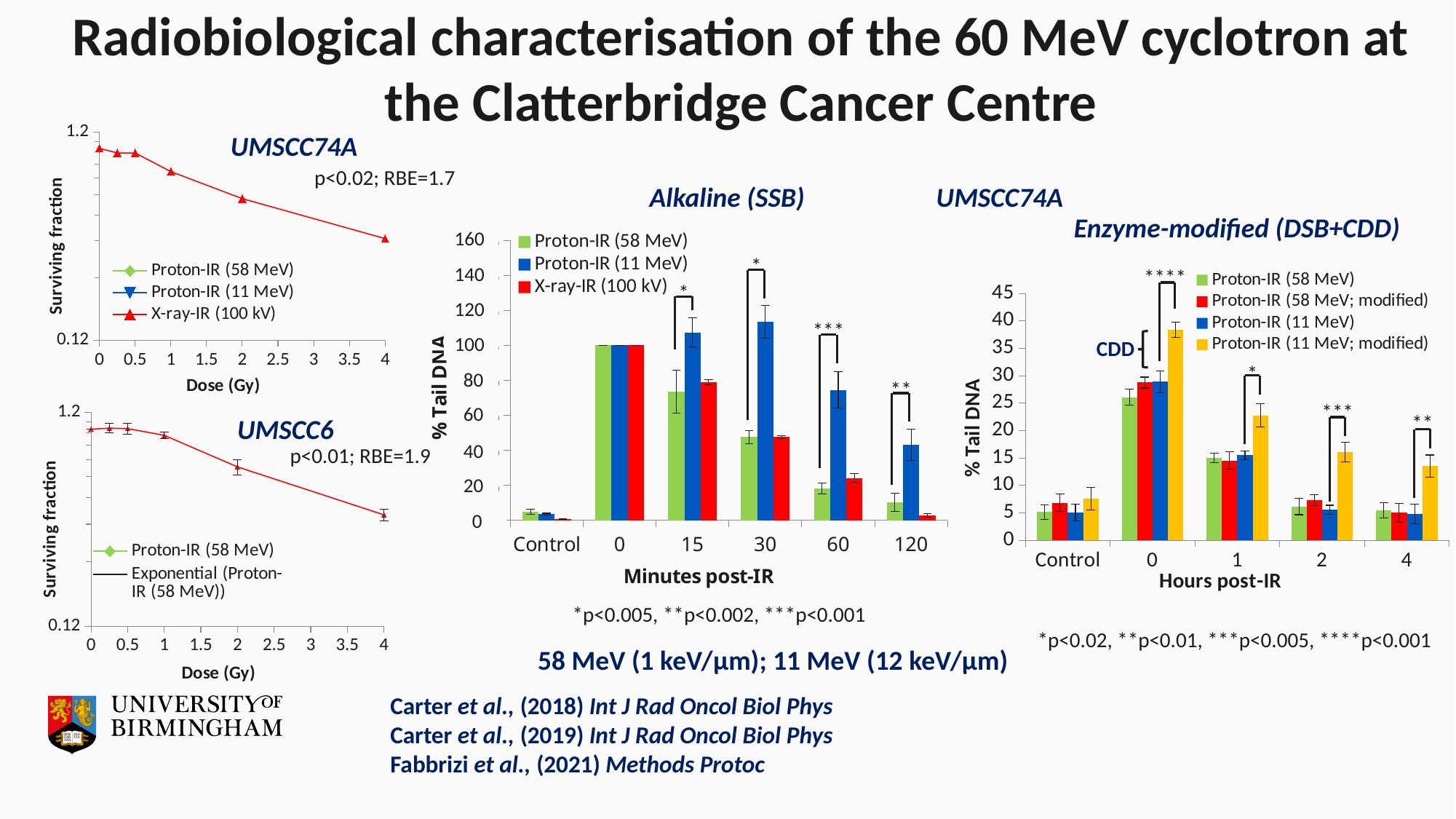
In the Enzyme-modified (DSB+CDD) chart, is the value for Proton-IR (11 MeV; modified) at 0 hours post-IR greater or less than 35? greater What kind of chart is the Enzyme-modified (DSB+CDD) chart? bar chart In the UMSCC6 line chart, does the surviving fraction rise or fall as dose increases from 0 to 4 Gy? fall In the Alkaline (SSB) chart, does the Proton-IR (11 MeV) series rise or fall from 0 to 120 minutes post-IR? fall In the Alkaline (SSB) chart, which series has the highest value at 15 minutes post-IR? Proton-IR (11 MeV) How many series does the legend of the Enzyme-modified (DSB+CDD) chart list? 4 In the Enzyme-modified (DSB+CDD) chart, which series has the highest value at 4 hours post-IR? Proton-IR (11 MeV; modified) In the Alkaline (SSB) chart, what is the % Tail DNA value for Proton-IR (58 MeV) at 0 minutes post-IR? 100 In the Alkaline (SSB) chart, at 60 minutes post-IR, which is larger: Proton-IR (11 MeV) or X-ray-IR (100 kV)? Proton-IR (11 MeV) How many categories are shown on the x axis of the Alkaline (SSB) chart? 6 In the Alkaline (SSB) chart, is the value for Proton-IR (11 MeV) at 30 minutes post-IR greater or less than 100? greater How many series does the legend of the Alkaline (SSB) chart list? 3